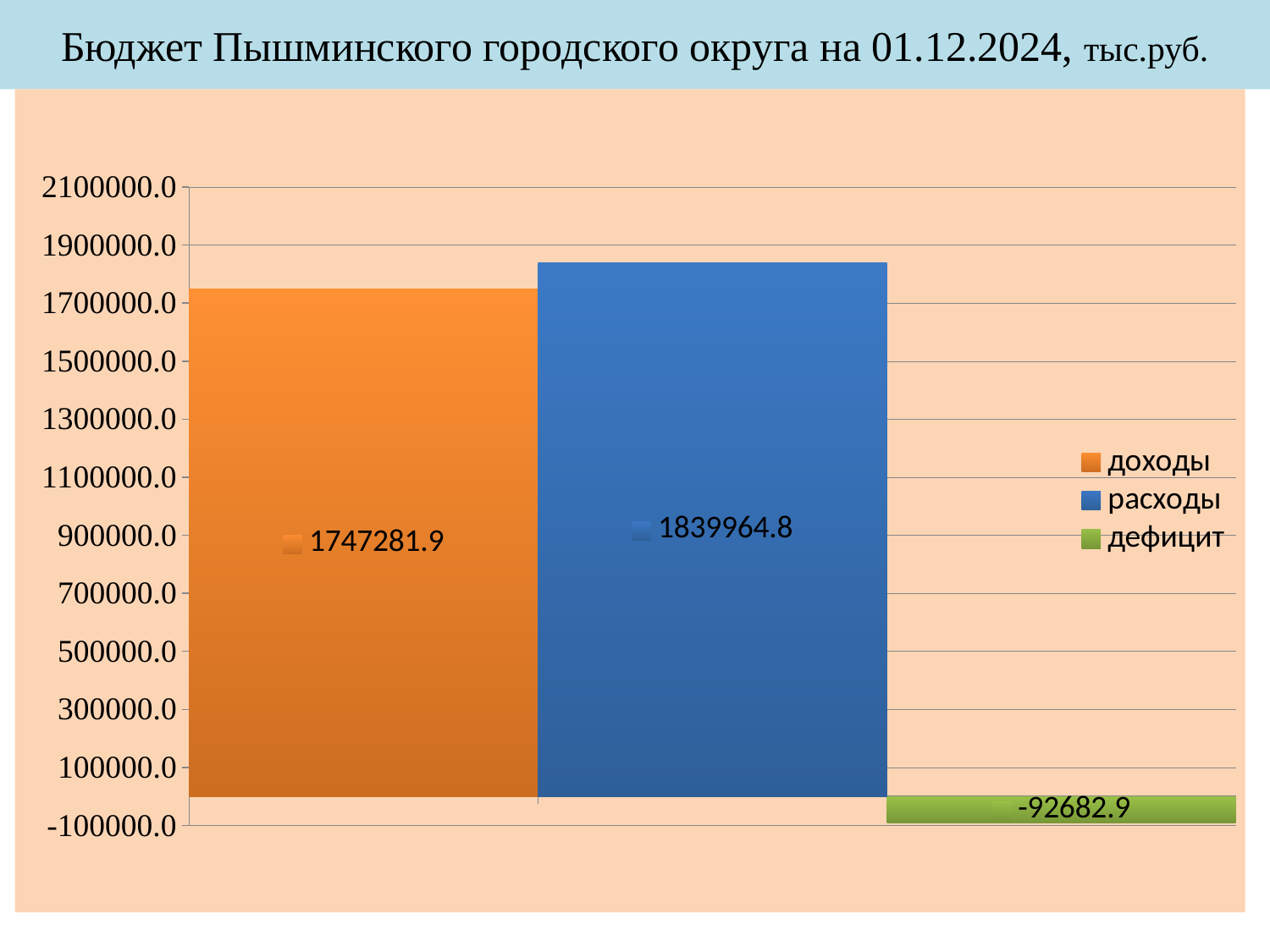
What is the difference between расходы and доходы? 92682.9 Is the value for доходы greater or less than 1700000.0? greater Which series has the lowest value? дефицит Is the value for расходы greater or less than 1900000.0? less How many series does the legend list? 3 What kind of chart is shown on the slide? bar chart What is the value for дефицит? -92682.9 Which is larger, доходы or расходы? расходы What is the title of the chart? Бюджет Пышминского городского округа на 01.12.2024, тыс.руб. Which series has the highest value? расходы What is the value for доходы? 1747281.9 What is the value for расходы? 1839964.8